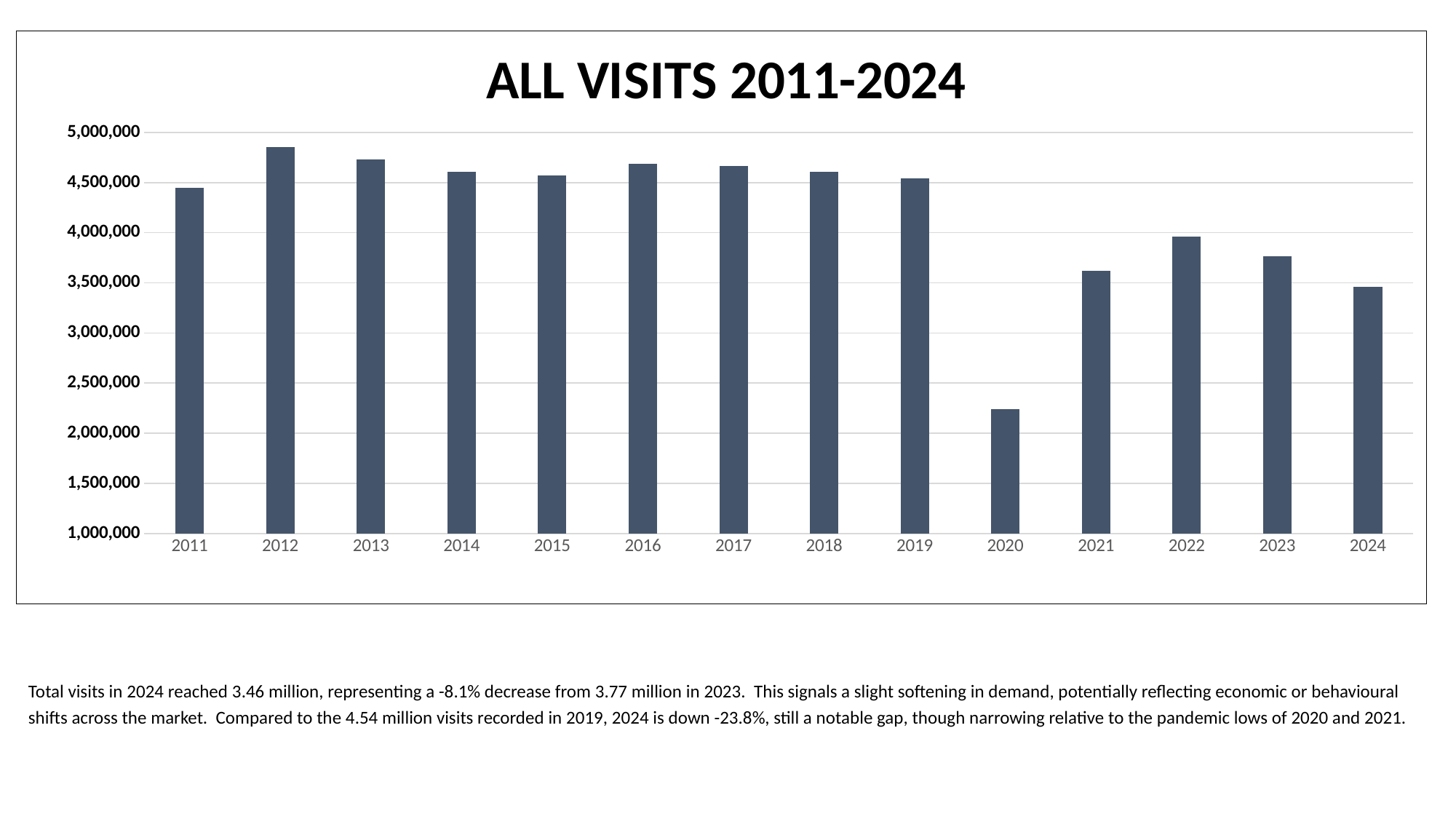
What is the title of the chart? ALL VISITS 2011-2024 Is the value for 2011 greater or less than 4,000,000? greater Which year has the lowest number of visits? 2020 Is the value for 2020 greater or less than 2,500,000? less Is the value for 2012 greater or less than 4,500,000? greater Which year has the highest number of visits? 2012 What type of chart is shown on the slide? Bar chart How many years are plotted on the chart? 14 Do visits rise or fall from 2019 to 2020? Fall Which year has more visits, 2022 or 2023? 2022 According to the text on the slide, how many visits were recorded in 2024? 3.46 million